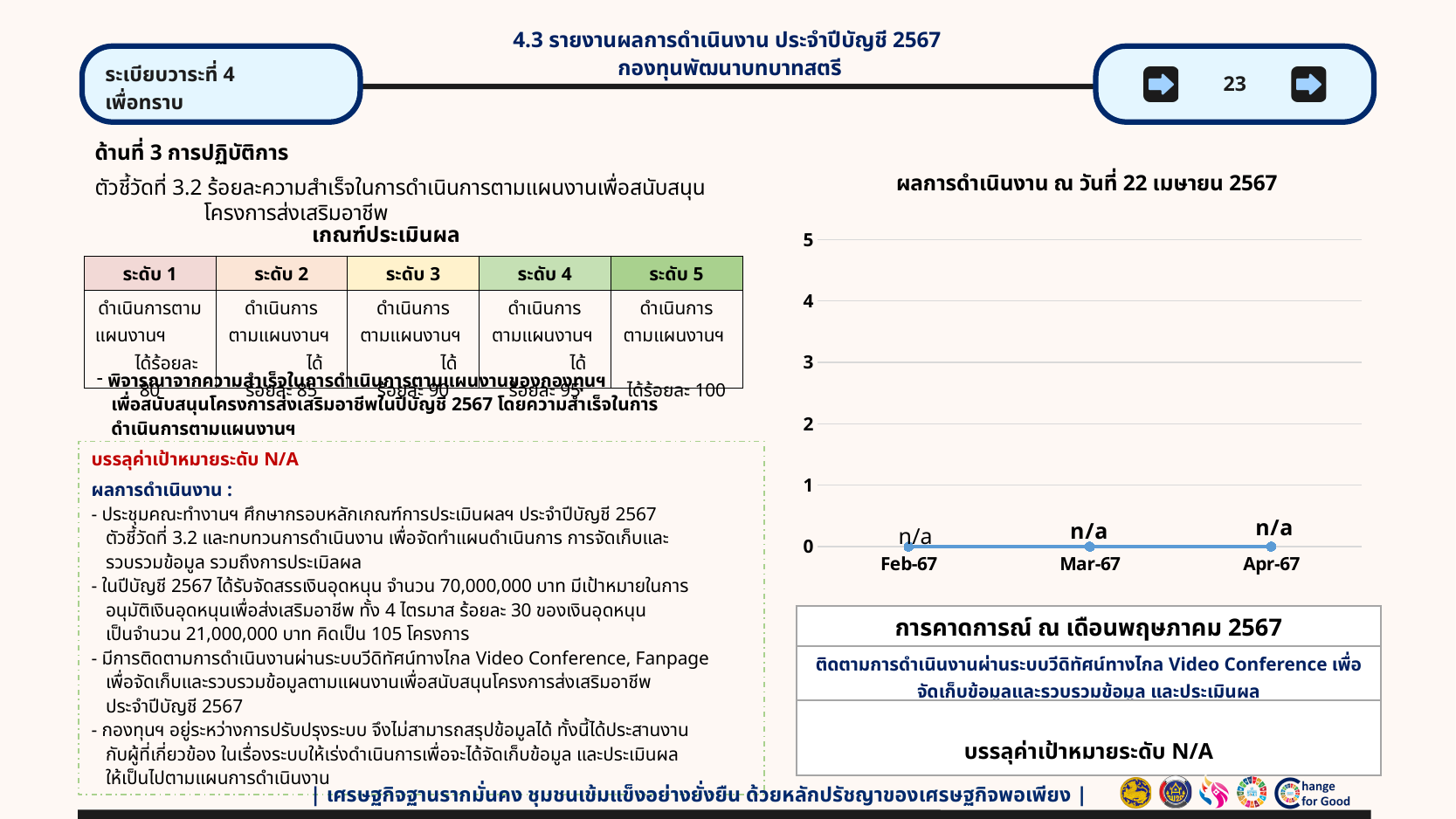
Which category is the first one on the x axis of the chart? Feb-67 What is the data label shown for Mar-67 on the chart? n/a What kind of chart is shown on the right side of the slide? line chart What is the highest value shown on the chart's y axis? 5 What is the data label shown for Feb-67 on the chart? n/a What is the title of the chart? ผลการดำเนินงาน ณ วันที่ 22 เมษายน 2567 Which category is the last one on the x axis of the chart? Apr-67 Is the plotted point for Mar-67 greater or less than 1 on the y axis? less What is the data label shown for Apr-67 on the chart? n/a Do the plotted values rise, fall, or stay flat from Feb-67 to Apr-67? stay flat How many data points are plotted on the chart? 3